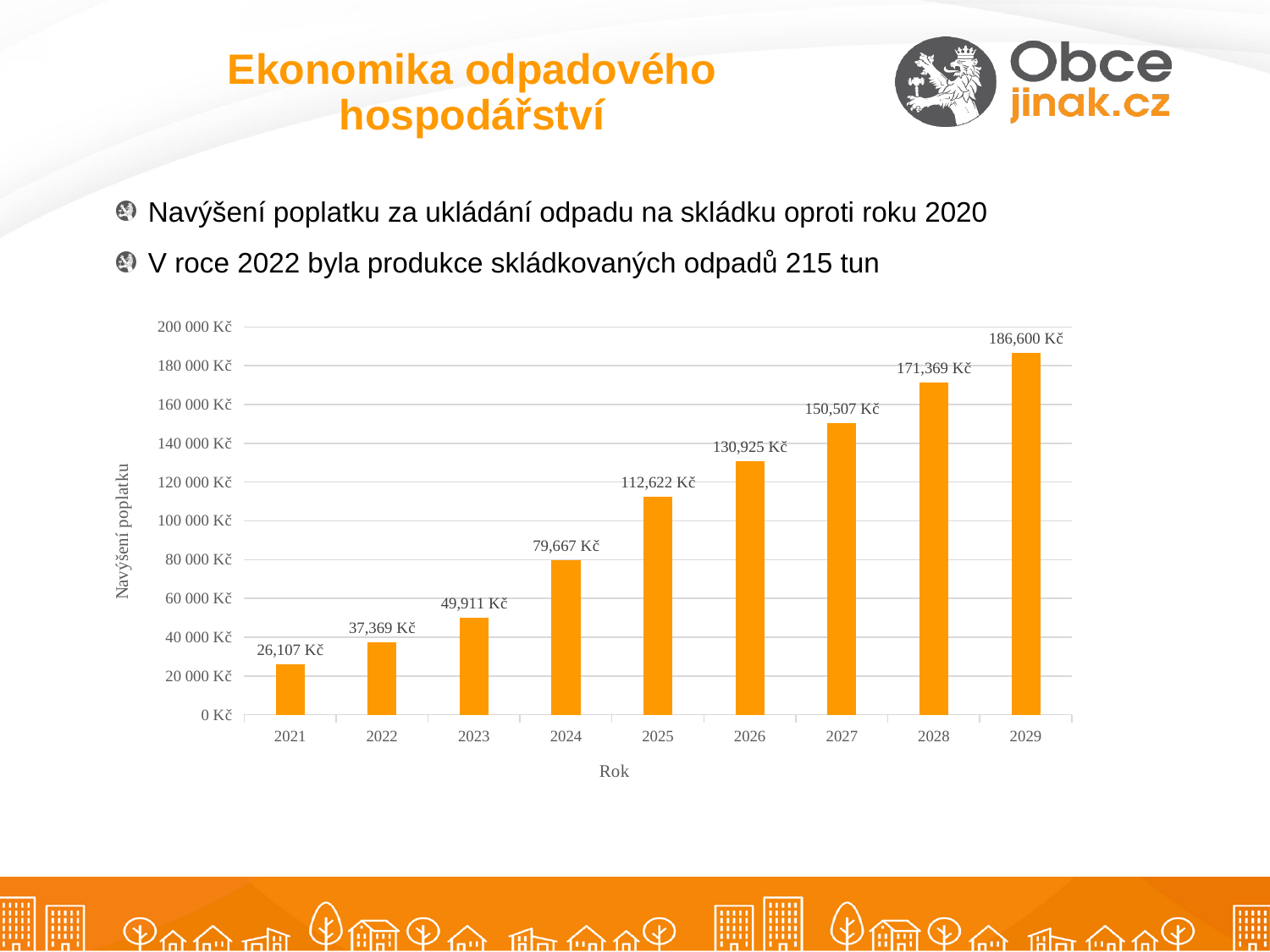
What is the value for 2021? 26,107 Kč Which year has the lowest value? 2021 Do the values rise or fall from 2021 to 2029? rise Which is larger, the value for 2025 or the value for 2026? 2026 What is the value for 2024? 79,667 Kč Which year has the highest value? 2029 What is the difference between the values for 2024 and 2023? 29,756 Kč What is the value for 2027? 150,507 Kč How many years are shown on the x axis? 9 Is the value for 2028 greater or less than 160 000 Kč? greater What is the difference between the values for 2029 and 2021? 160,493 Kč What kind of chart is shown on the slide? bar chart